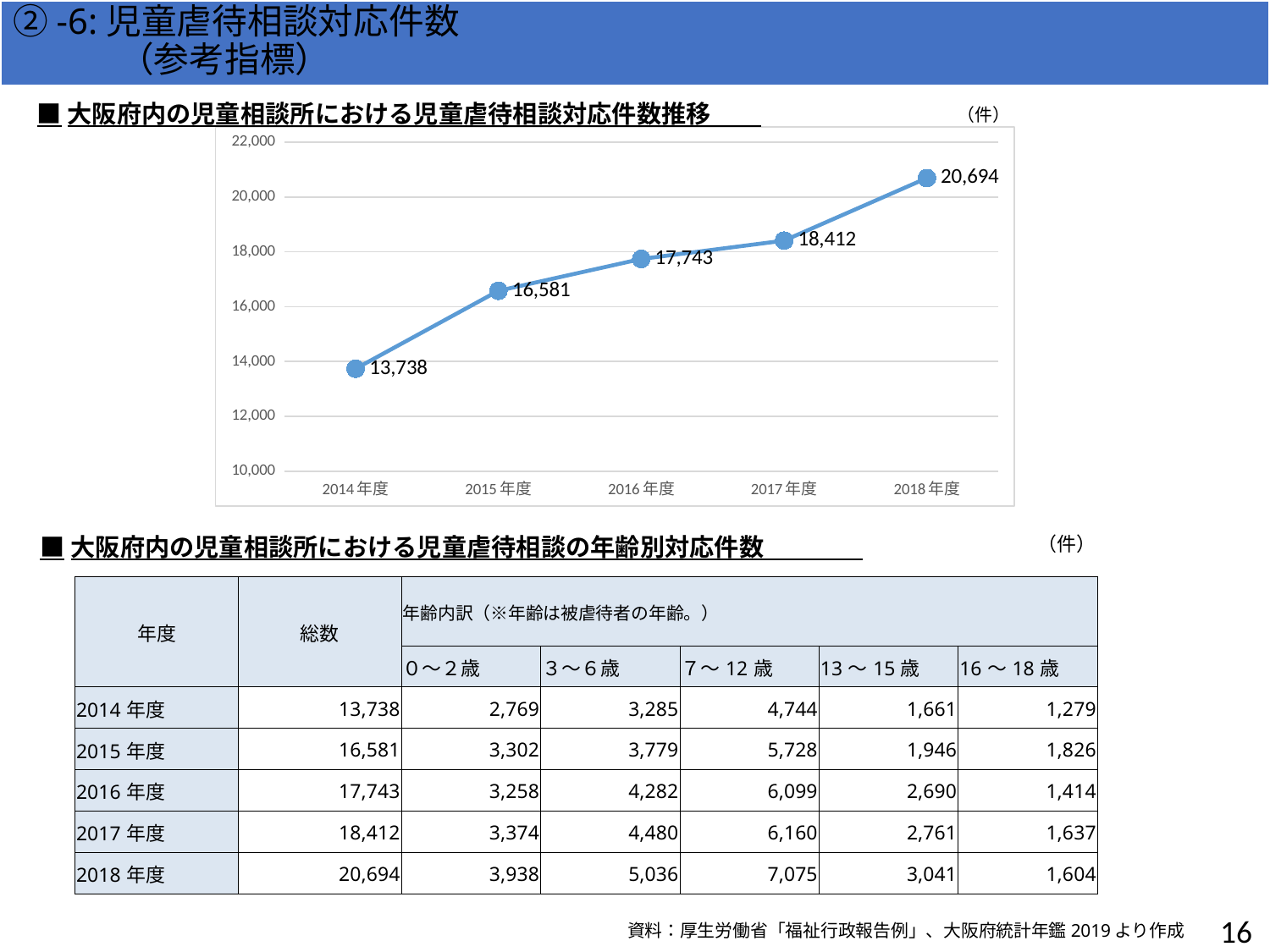
What kind of chart is shown at the top of the slide? line chart What is the value for 2018年度 in the line chart? 20,694 Which year has the lowest value in the line chart? 2014年度 Do the values in the line chart rise or fall from 2014年度 to 2018年度? rise What is the value for 2016年度 in the line chart? 17,743 What is the difference between the values for 2018年度 and 2017年度 in the line chart? 2,282 Which is larger in the line chart, the value for 2016年度 or 2017年度? 2017年度 What is the value for 2014年度 in the line chart? 13,738 How many data points are plotted in the line chart? 5 Is the value for 2017年度 in the line chart greater or less than 18,000? greater What is the difference between the values for 2015年度 and 2014年度 in the line chart? 2,843 Which year has the highest value in the line chart? 2018年度